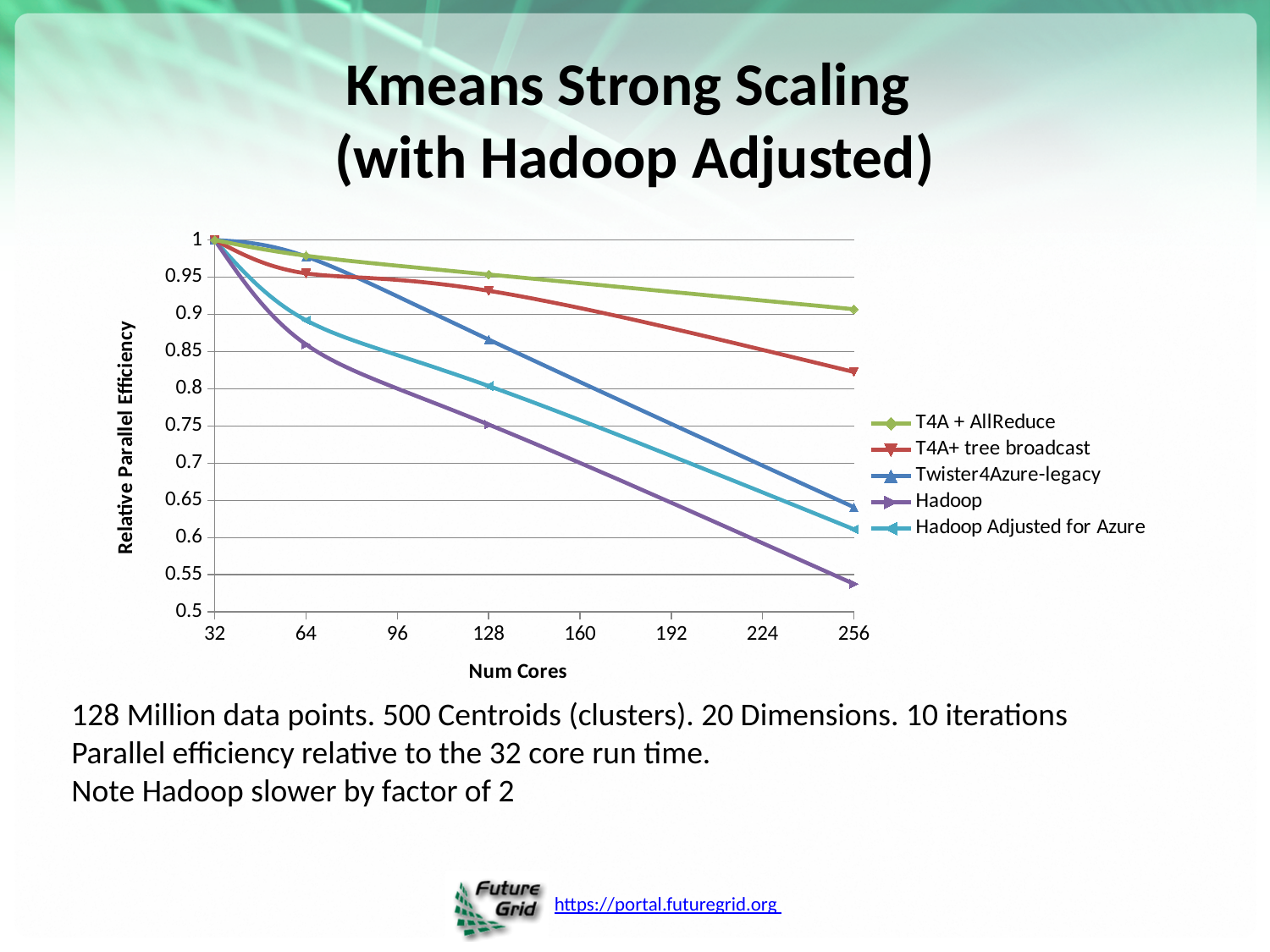
Which series has the highest relative parallel efficiency at 256 cores? T4A + AllReduce What kind of chart is shown on the slide? line chart Is the value for Twister4Azure-legacy at 128 cores greater or less than 0.8? greater At 128 cores, which is larger: T4A+ tree broadcast or Twister4Azure-legacy? T4A+ tree broadcast Which series has the lowest relative parallel efficiency at 256 cores? Hadoop Is the value for T4A + AllReduce at 256 cores greater or less than 0.85? greater Do the values for Hadoop rise or fall as the number of cores increases? fall At 256 cores, which is larger: Hadoop or Hadoop Adjusted for Azure? Hadoop Adjusted for Azure How many series does the legend list? 5 What is the relative parallel efficiency of Hadoop at 32 cores? 1 What is the label of the x axis? Num Cores Is the value for Hadoop at 256 cores greater or less than 0.6? less